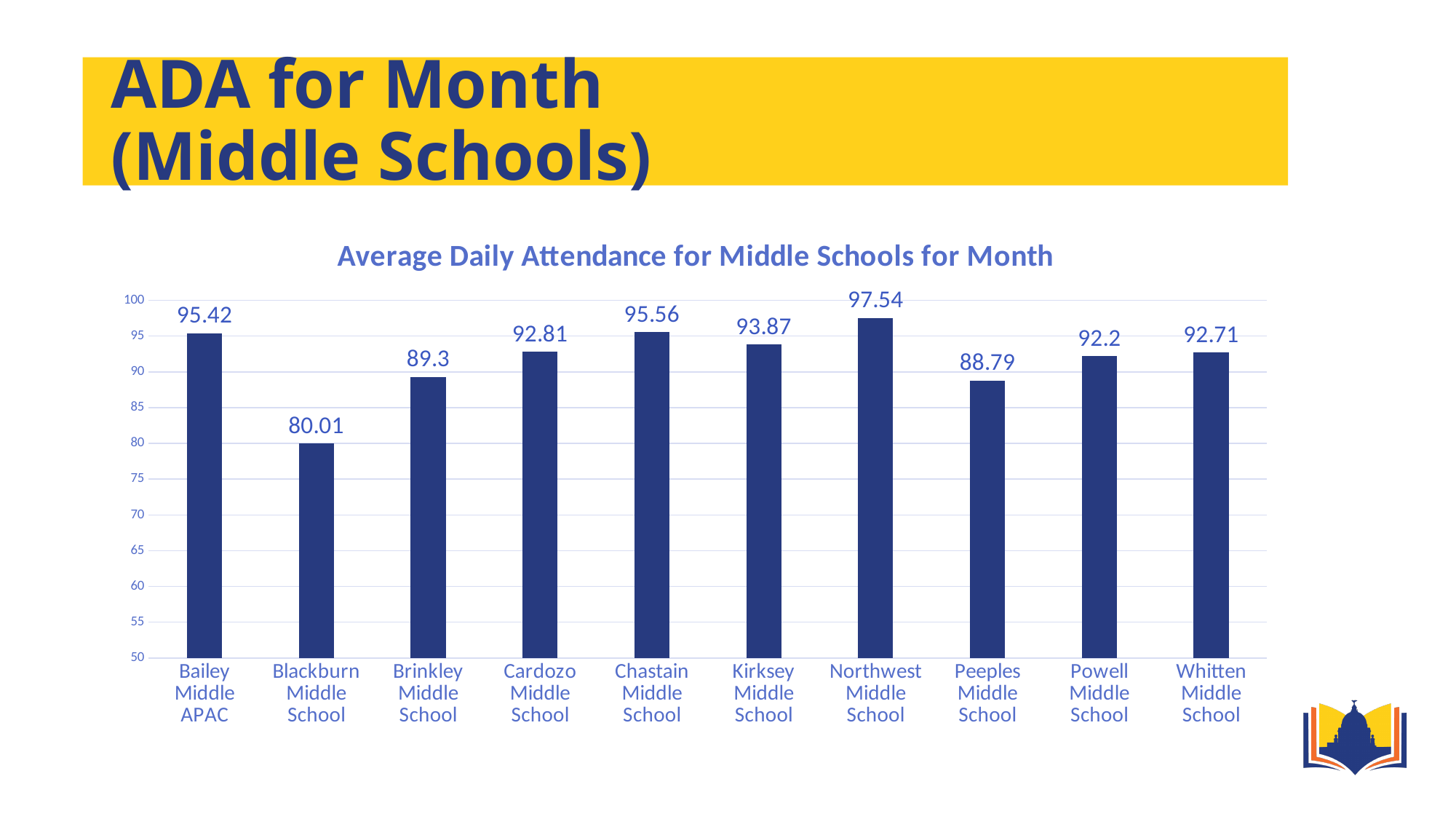
Which has a higher average daily attendance, Kirksey Middle School or Peeples Middle School? Kirksey Middle School How many schools are shown on the chart? 10 What kind of chart is shown on the slide? Bar chart Which school has the lowest average daily attendance? Blackburn Middle School What is the value shown for Powell Middle School? 92.2 What is the average daily attendance for Blackburn Middle School? 80.01 What is the value shown for Bailey Middle APAC? 95.42 What is the average daily attendance for Northwest Middle School? 97.54 What is the difference between the values for Northwest Middle School and Blackburn Middle School? 17.53 What is the title of the chart? Average Daily Attendance for Middle Schools for Month Which school has the highest average daily attendance? Northwest Middle School Is the value for Brinkley Middle School greater or less than 90? less